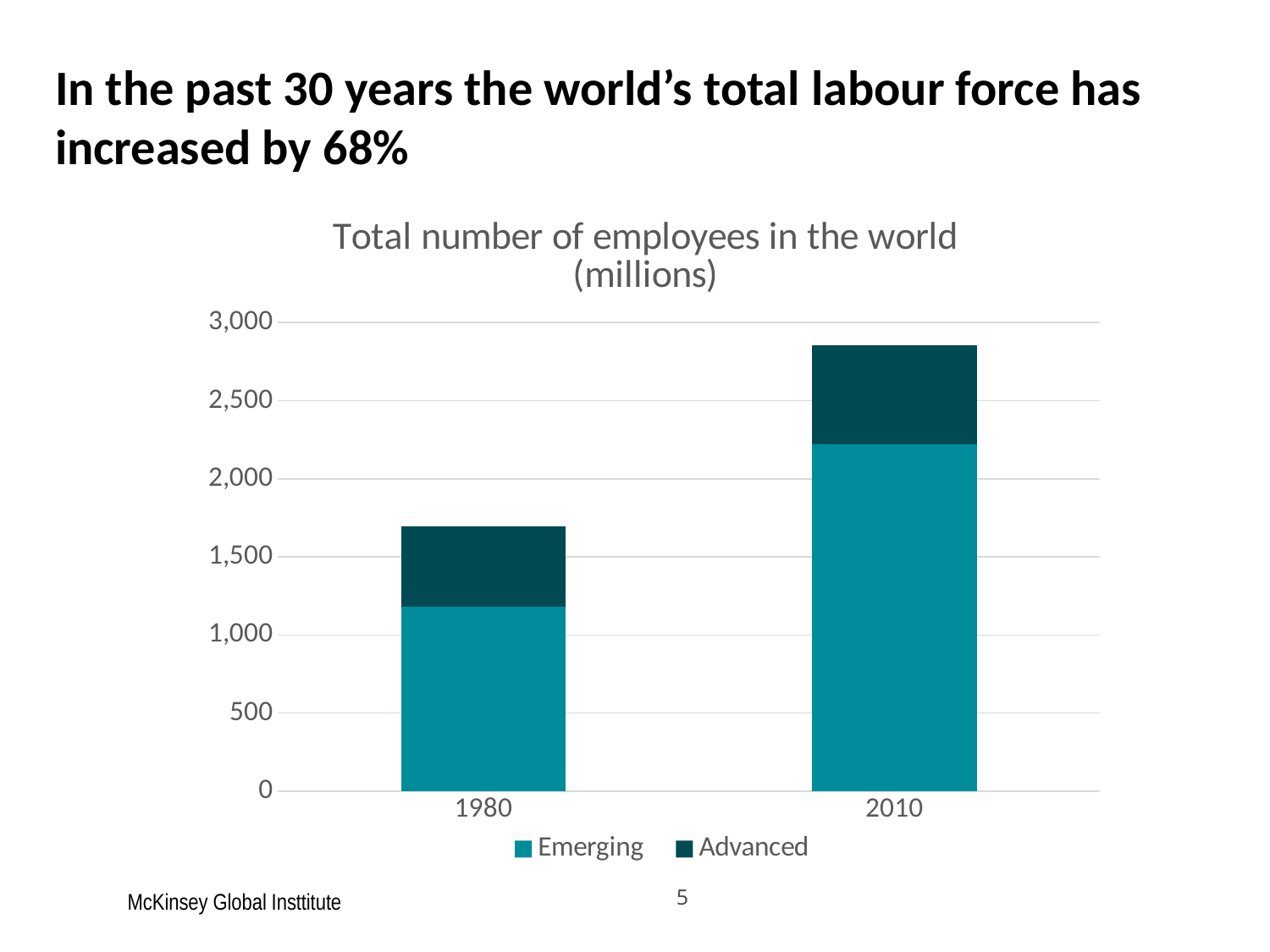
Is the total height of the 1980 bar greater or less than 2,000? less How many years (categories) are shown on the x axis? 2 What kind of chart is shown on the slide? Stacked bar chart What are the two series listed in the legend? Emerging and Advanced Is the Emerging value for 2010 greater or less than 2,000? greater Which year has the larger total number of employees, 1980 or 2010? 2010 Is the total height of the 2010 bar greater or less than 2,500? greater What is the title of the chart? Total number of employees in the world (millions) In 2010, which segment is larger, Emerging or Advanced? Emerging How many series does the legend list? 2